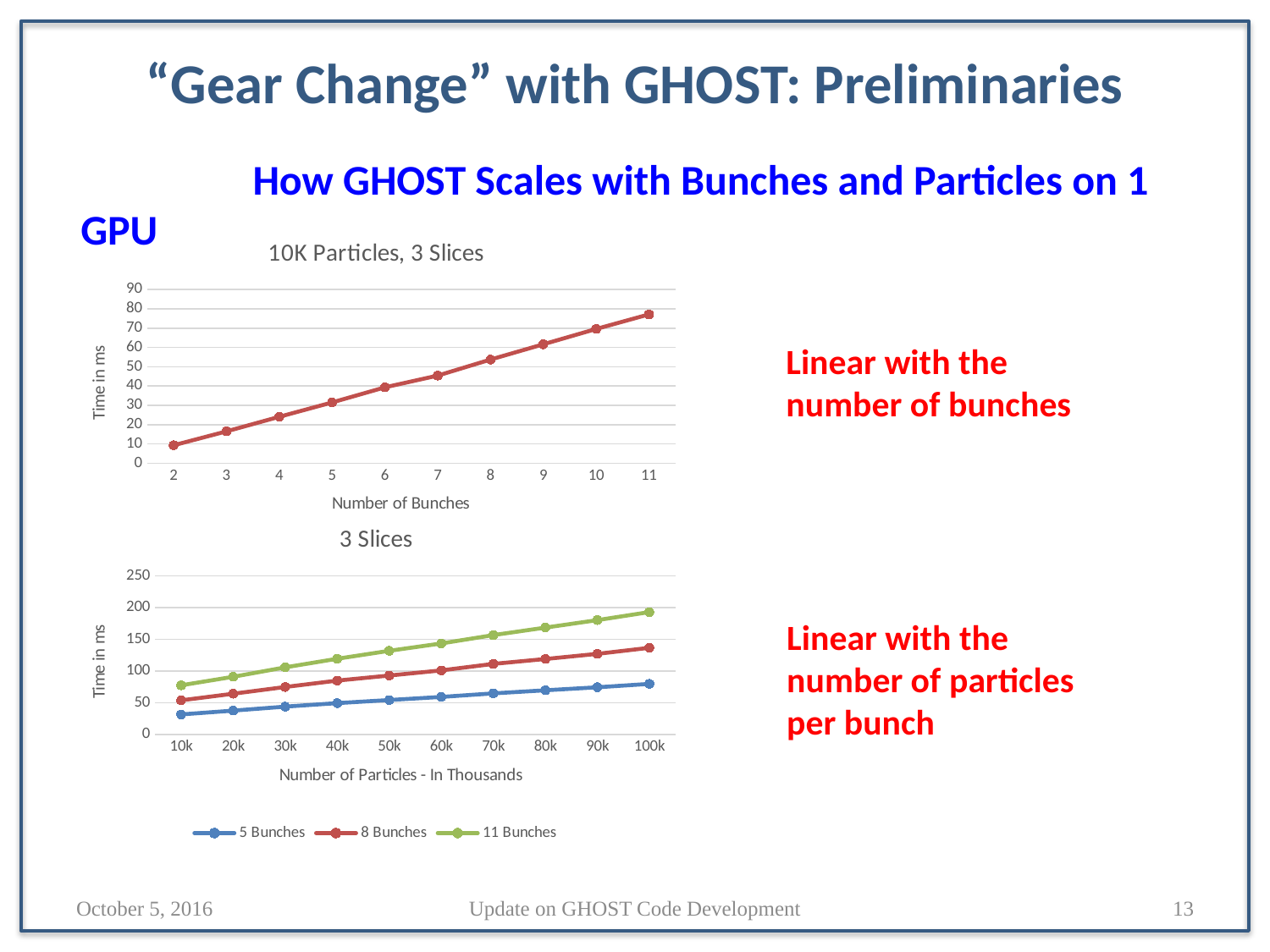
In the chart titled "10K Particles, 3 Slices", what is the label of the x axis? Number of Bunches In the chart titled "3 Slices", is the value for 5 Bunches at 100k particles greater or less than 100? less In the chart titled "3 Slices", which series has the highest time at 100k particles? 11 Bunches In the chart titled "10K Particles, 3 Slices", is the value for 2 bunches greater or less than 20? less In the chart titled "10K Particles, 3 Slices", what kind of chart is it? line chart In the chart titled "3 Slices", is the value for 11 Bunches at 100k particles greater or less than 150? greater In the chart titled "3 Slices", how many series does the legend list? 3 In the chart titled "3 Slices", which series has the lowest time at 10k particles? 5 Bunches In the chart titled "10K Particles, 3 Slices", how many data points are plotted along the x axis? 10 In the chart titled "3 Slices", which is larger at 50k particles: the value for 8 Bunches or the value for 5 Bunches? 8 Bunches In the chart titled "10K Particles, 3 Slices", does the time rise or fall as the number of bunches increases? rise